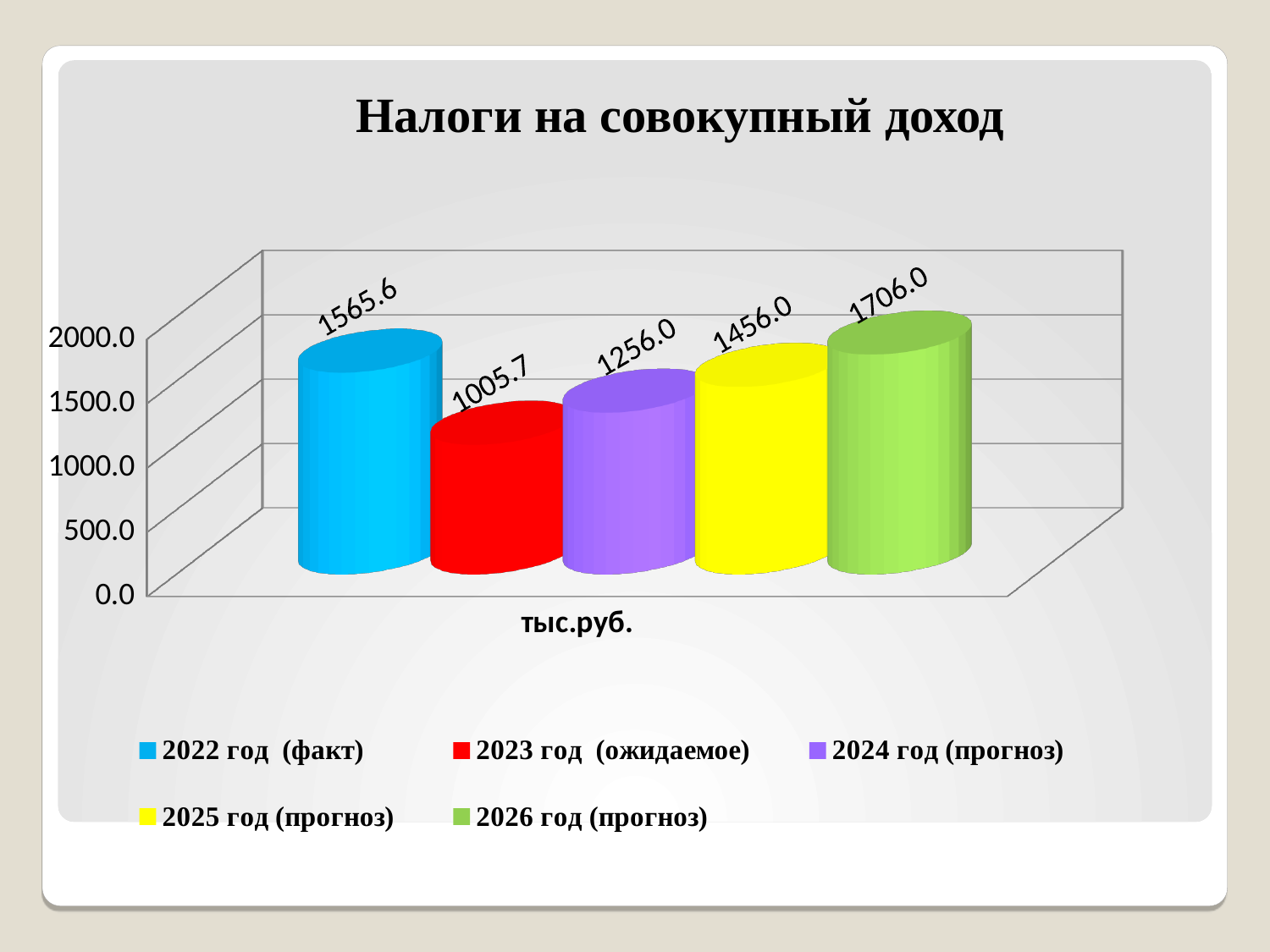
Which year has the highest value? 2026 год (прогноз) What is the difference between the values for 2026 год (прогноз) and 2025 год (прогноз)? 250.0 Is the value for 2023 год (ожидаемое) greater or less than 1500? less Which year has the lowest value? 2023 год (ожидаемое) What is the value for 2022 год (факт)? 1565.6 What kind of chart is shown? bar chart What is the value for 2024 год (прогноз)? 1256.0 What is the value for 2023 год (ожидаемое)? 1005.7 How many series does the legend list? 5 Which is larger, the value for 2022 год (факт) or the value for 2025 год (прогноз)? 2022 год (факт) What is the value for 2026 год (прогноз)? 1706.0 What is the title of the chart? Налоги на совокупный доход